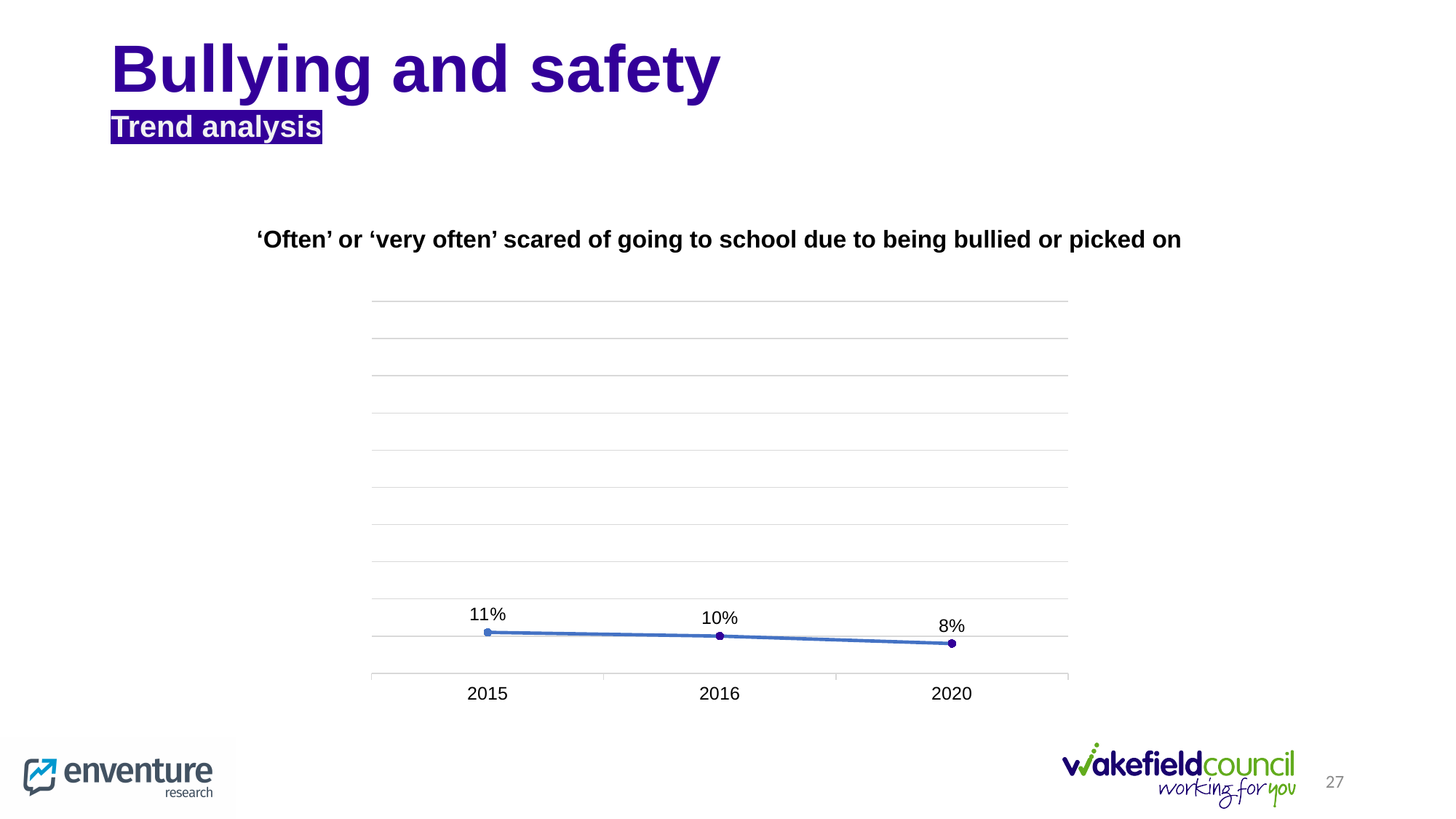
Which year has the lowest value? 2020 What is the difference between the values for 2015 and 2020? 3% Which year has the highest value? 2015 How many years are plotted on the chart? 3 Do the values rise or fall from 2015 to 2020? fall What kind of chart is shown on the slide? line chart What is the value for 2016? 10% What is the value for 2015? 11% Which is larger, the value for 2015 or the value for 2016? 2015 What is the difference between the values for 2016 and 2020? 2% What is the value for 2020? 8% What is the title of the chart? ‘Often’ or ‘very often’ scared of going to school due to being bullied or picked on